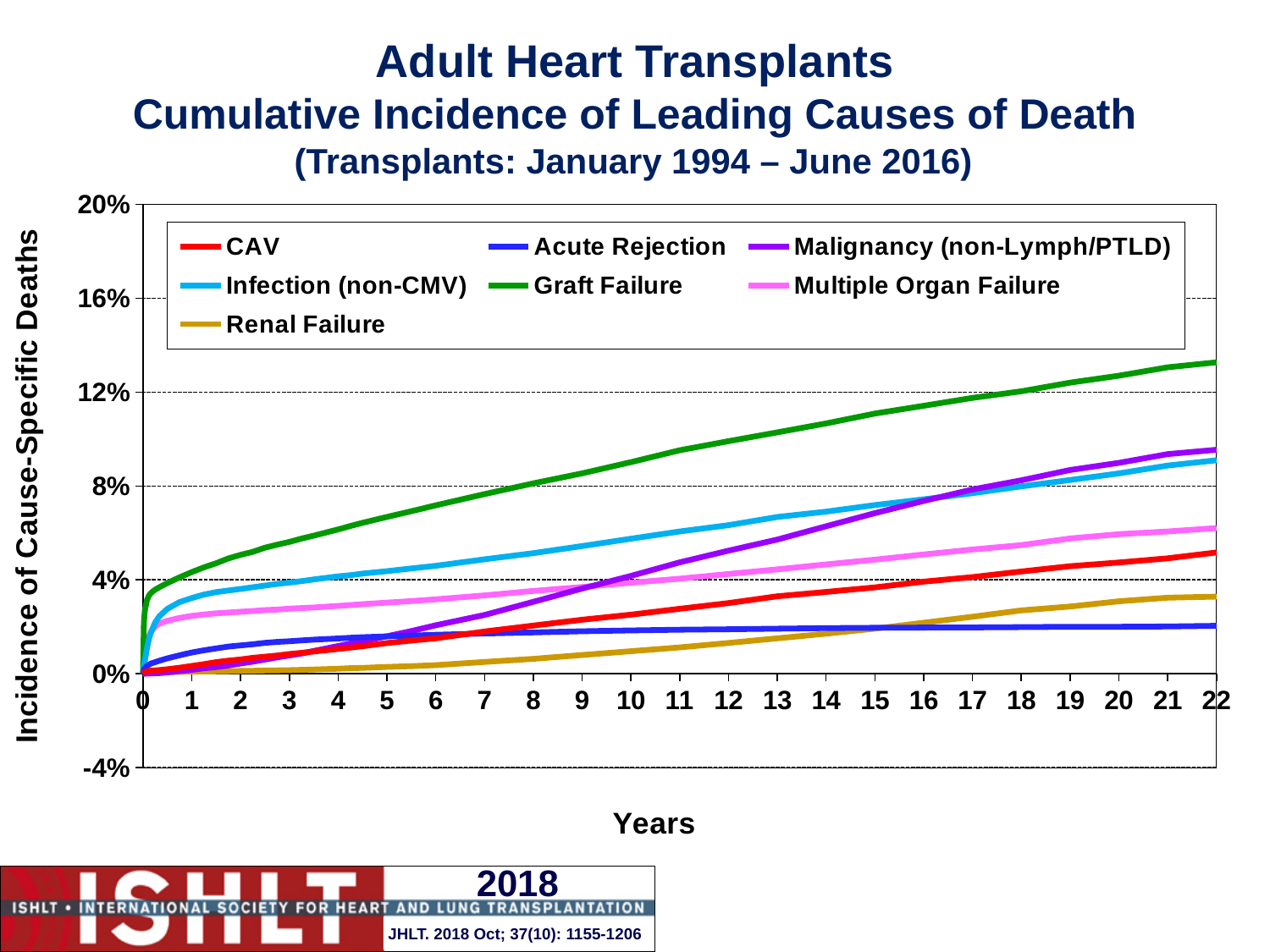
What is the label of the y axis? Incidence of Cause-Specific Deaths Which cause of death has the highest cumulative incidence at year 22? Graft Failure At year 22, which is larger: Multiple Organ Failure or CAV? Multiple Organ Failure What kind of chart is shown on the slide? line chart How many series does the legend list? 7 Is the value for Renal Failure at year 22 greater or less than 4%? less Is the value for Acute Rejection at year 22 greater or less than 4%? less Is the value for Malignancy (non-Lymph/PTLD) at year 22 greater or less than 8%? greater Which cause of death has the lowest cumulative incidence at year 22? Acute Rejection At year 22, which is larger: Graft Failure or Infection (non-CMV)? Graft Failure Does the Graft Failure line rise or fall as years increase? rise